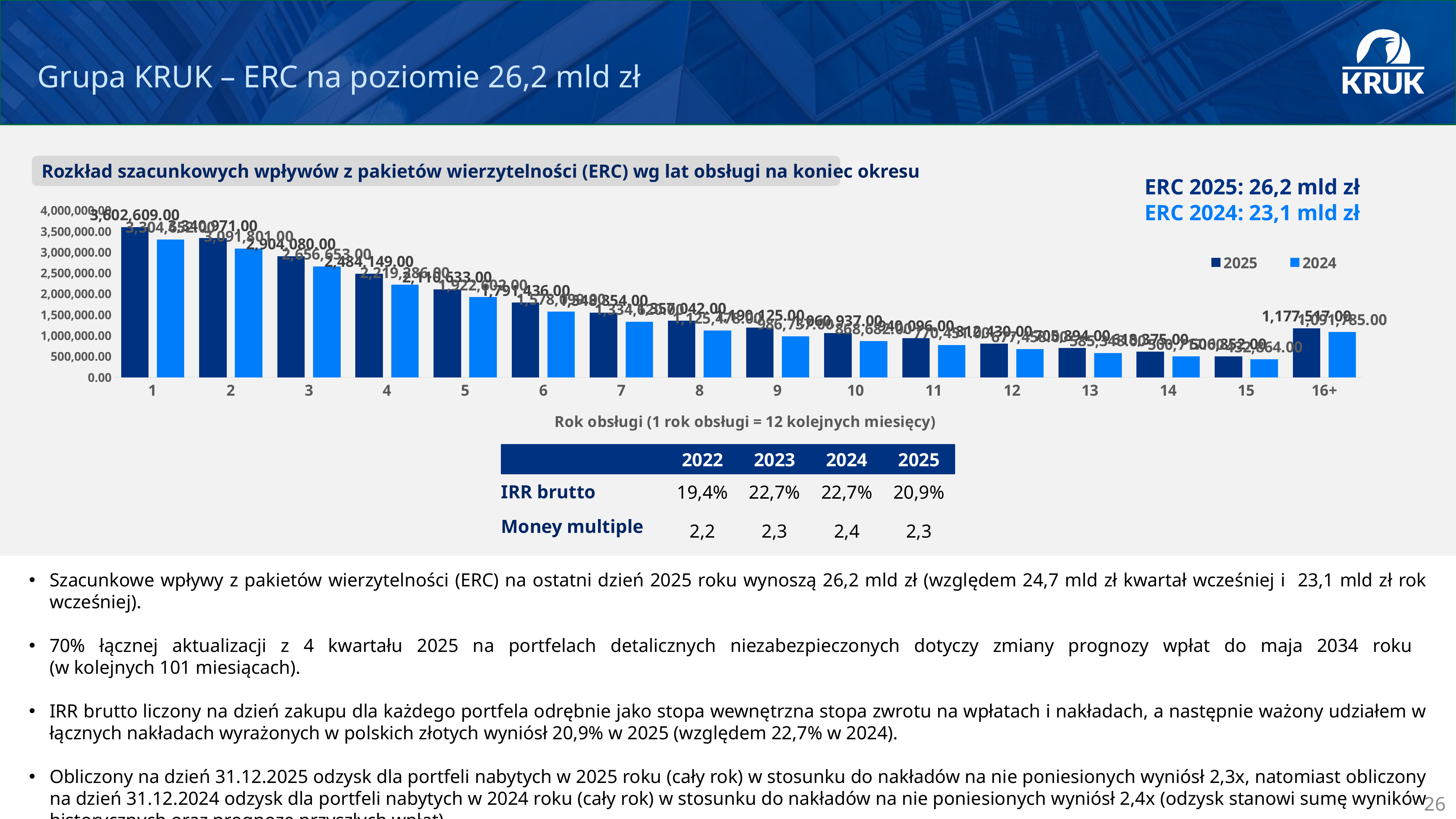
How many series does the chart legend list? 2 Is the 2025 value for service year 12 greater or less than 1,000,000.00? less Which service-year category has the lowest 2024 value? 15 What is the difference between the 2025 values for service year 1 and the 16+ category? 2,425,092.00 What is the 2025 value for service year 1? 3,602,609.00 What is the 2025 value for service year 4? 2,484,149.00 For service year 1, which series is larger, 2025 or 2024? 2025 Do the 2025 values rise or fall from service year 1 to service year 15? fall Which service-year category has the highest 2025 value? 1 What kind of chart is shown on the slide? bar chart How many service-year categories are shown on the x axis of the chart? 16 What is the 2025 value for the 16+ service-year category? 1,177,517.00